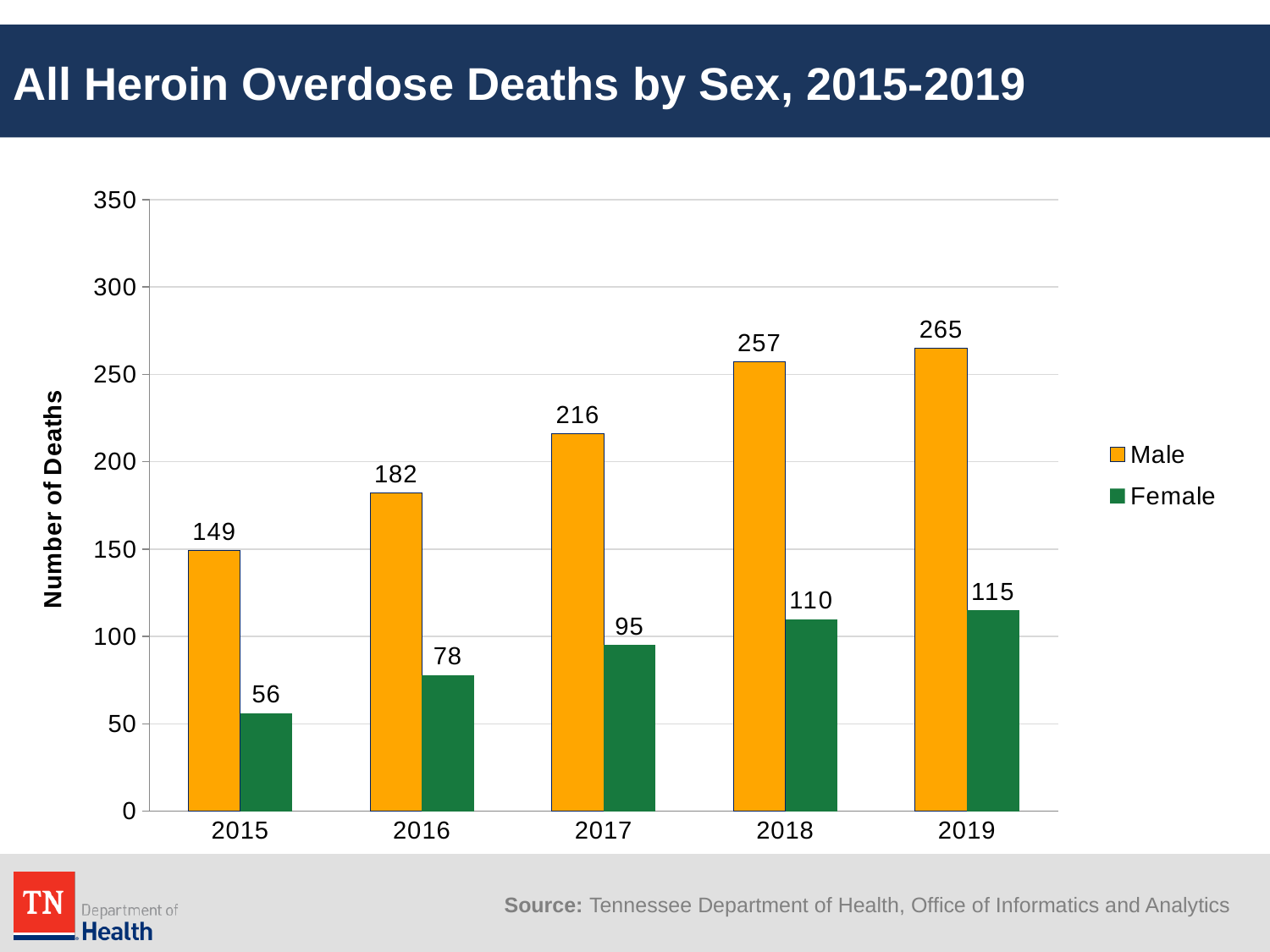
What is the difference between male and female heroin overdose deaths in 2018? 147 Do female heroin overdose deaths rise or fall from 2015 to 2019? Rise How many male heroin overdose deaths were there in 2017? 216 Is the value for male deaths in 2019 greater or less than 250? greater In which year were female heroin overdose deaths lowest? 2015 In which year were male heroin overdose deaths highest? 2019 What is the title of the chart? All Heroin Overdose Deaths by Sex, 2015-2019 What kind of chart is shown on the slide? Bar chart How many series does the legend list? 2 Which was larger in 2016: male deaths or female deaths? Male How many female heroin overdose deaths were there in 2015? 56 How many years are shown on the x axis? 5